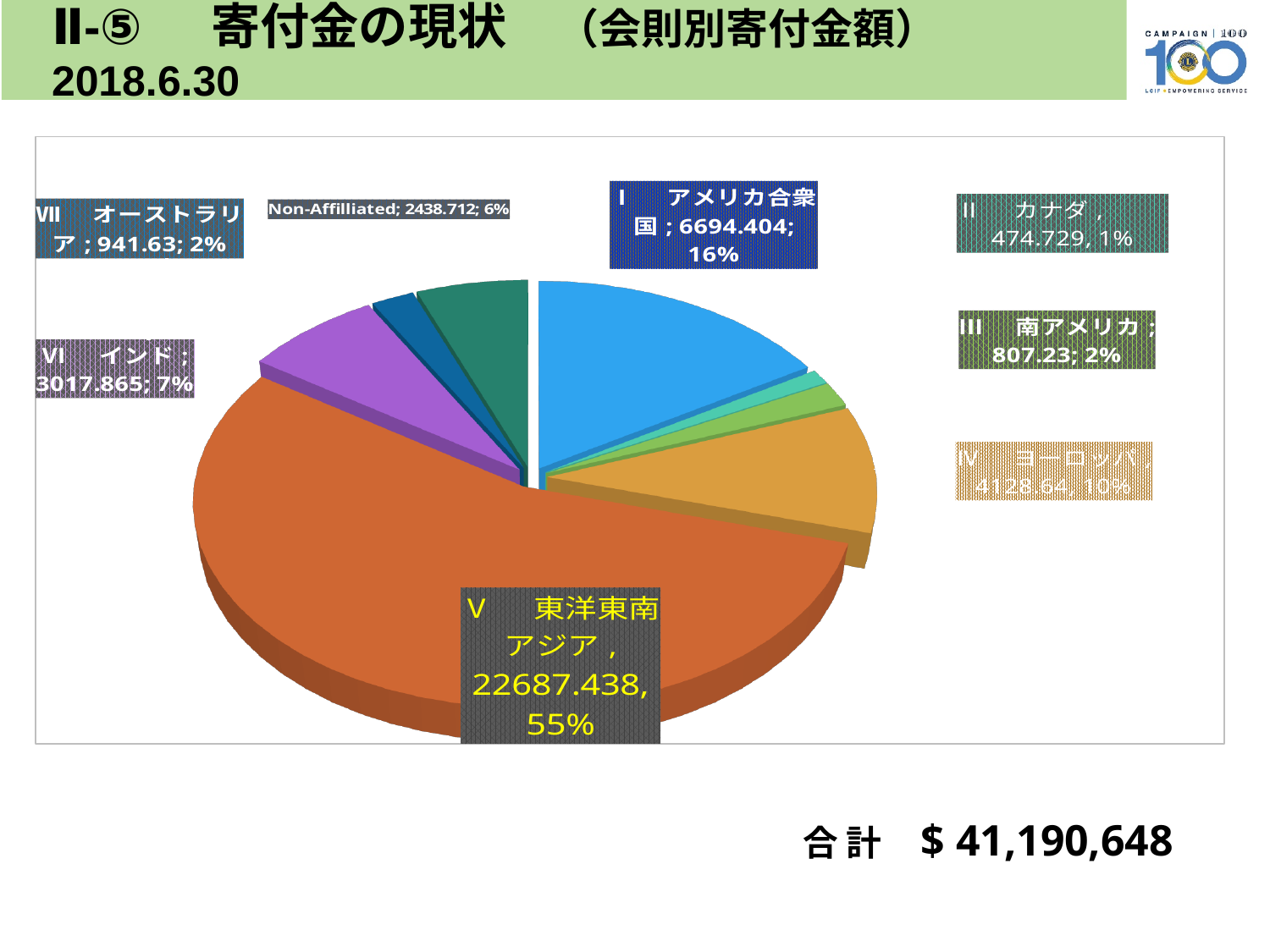
What kind of chart is shown on the slide? pie chart What is the value shown for Ⅴ 東洋東南アジア? 22687.438 What is the difference between the value for Ⅰ アメリカ合衆国 and the value for Ⅳ ヨーロッパ? 2565.764 Which category has the smallest slice in the pie chart? Ⅱ カナダ What percentage share does Non-Affilliated have in the pie chart? 6% What is the value shown for Ⅱ カナダ? 474.729 What percentage share does Ⅳ ヨーロッパ have in the pie chart? 10% What percentage share does Ⅴ 東洋東南アジア have in the pie chart? 55% How many slices does the pie chart have? 8 Which is larger, the value for Ⅵ インド or the value for Non-Affilliated? Ⅵ インド Which category has the largest slice in the pie chart? Ⅴ 東洋東南アジア What is the value shown for Ⅰ アメリカ合衆国? 6694.404